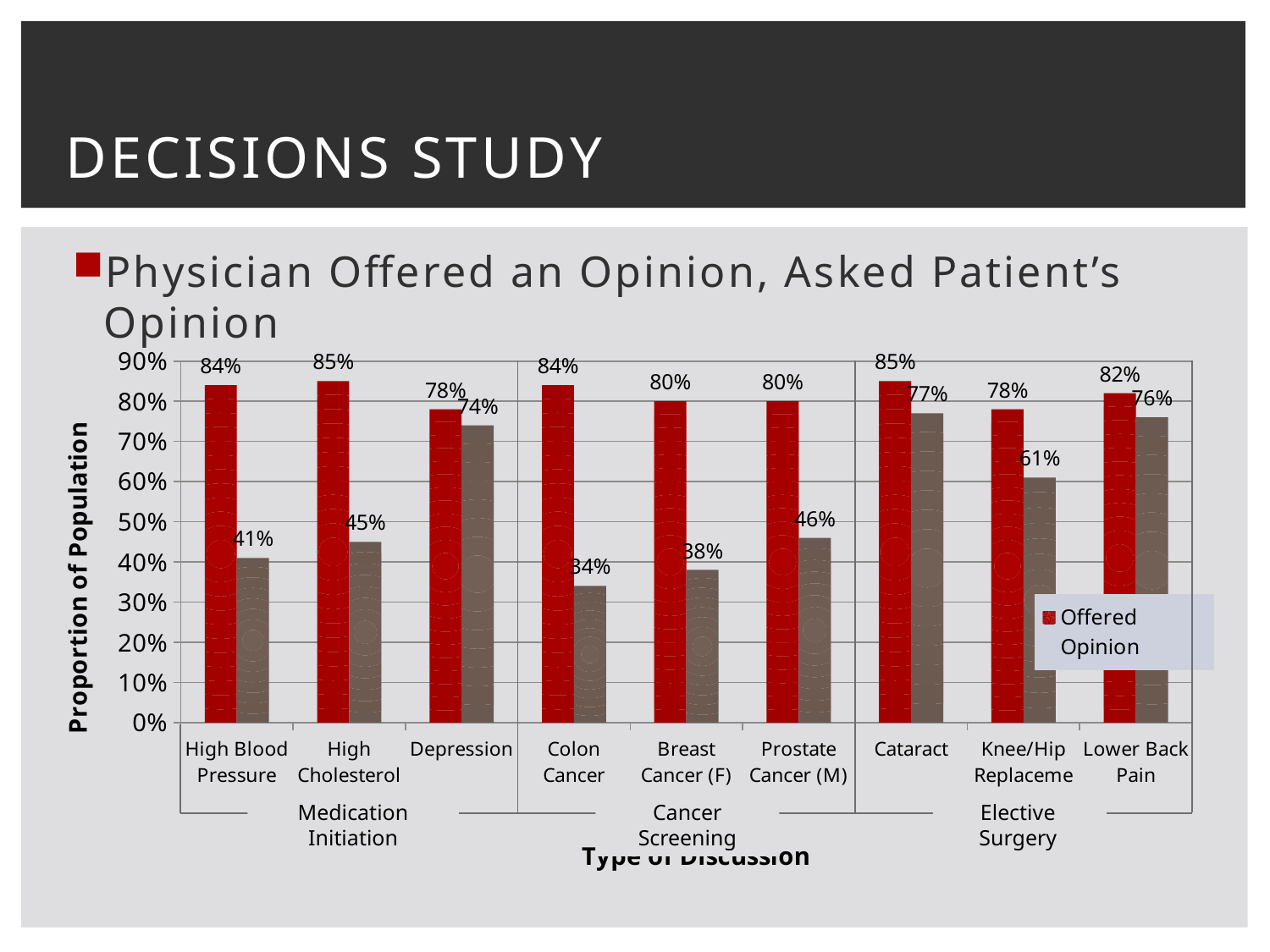
Which is larger: the grey bar for Cataract or the grey bar for Knee/Hip Replacement? Cataract What type of chart is shown on the slide? bar chart Which category has the lowest value for the grey series? Colon Cancer What is the value of the grey bar for Colon Cancer? 34% How many categories are shown along the x axis? 9 What is the difference between the Offered Opinion value and the grey bar value for Colon Cancer? 50 percentage points Is the grey bar value for High Blood Pressure greater or less than 50%? less What is the value of the grey bar for Knee/Hip Replacement? 61% What is the label of the y axis? Proportion of Population What is the Offered Opinion value for High Cholesterol? 85% What is the difference between the red and grey bars for Depression? 4 percentage points What is the Offered Opinion value for Lower Back Pain? 82%